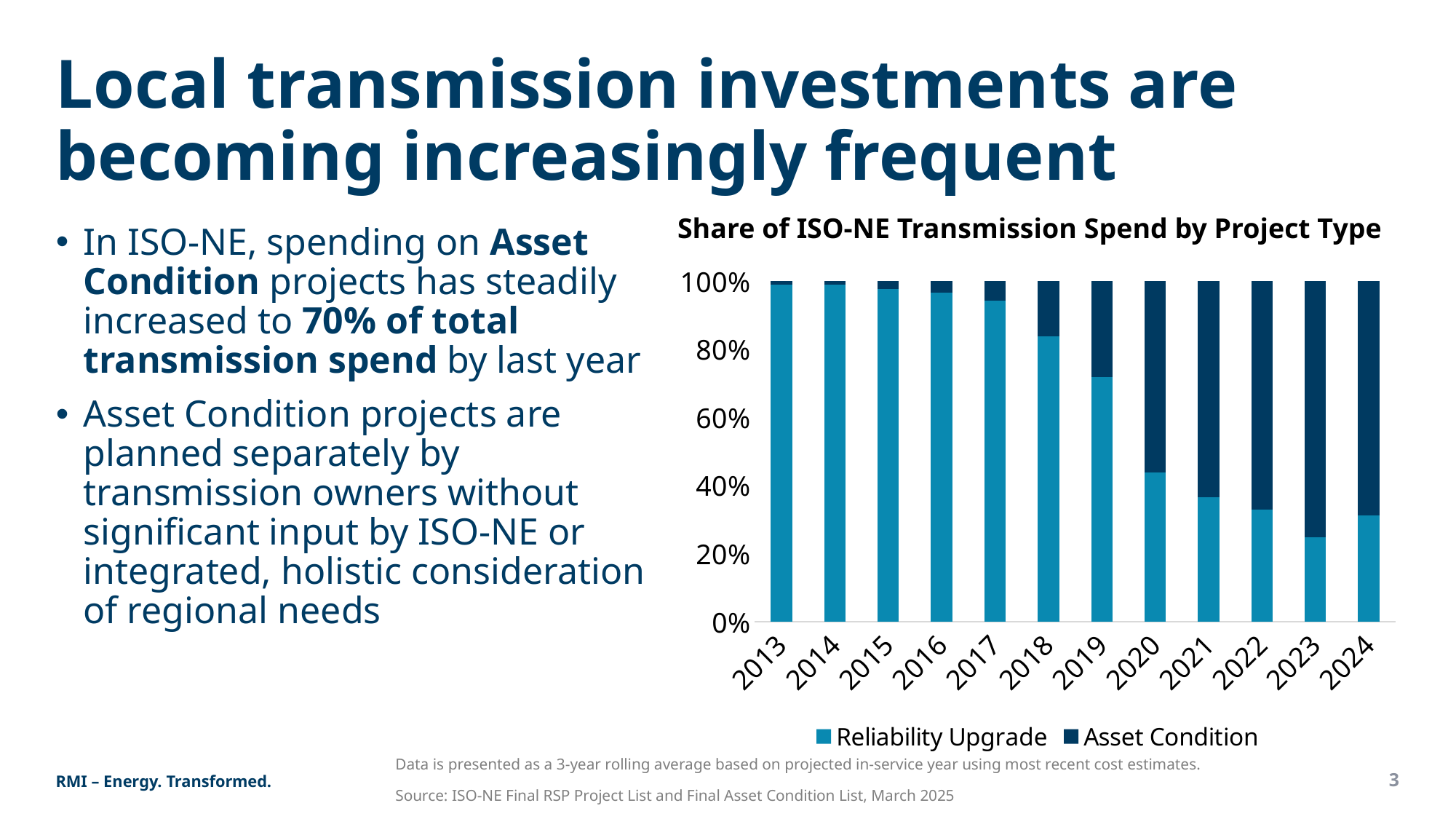
In which year is the Reliability Upgrade share the lowest? 2023 Does the share of Asset Condition spending rise or fall from 2013 to 2024? Rise Which series is shown in the darker blue colour in the chart? Asset Condition What is the title of the chart? Share of ISO-NE Transmission Spend by Project Type Which year has a larger Reliability Upgrade share, 2019 or 2020? 2019 Is the Reliability Upgrade share for 2019 greater or less than 60%? greater What kind of chart is shown on the slide? Stacked bar chart How many series does the chart's legend list? 2 Is the Reliability Upgrade share for 2018 greater or less than 80%? greater Is the Reliability Upgrade share for 2024 greater or less than 40%? less Does the share of Reliability Upgrade spending rise or fall from 2013 to 2024? Fall How many years are shown on the x axis of the chart? 12